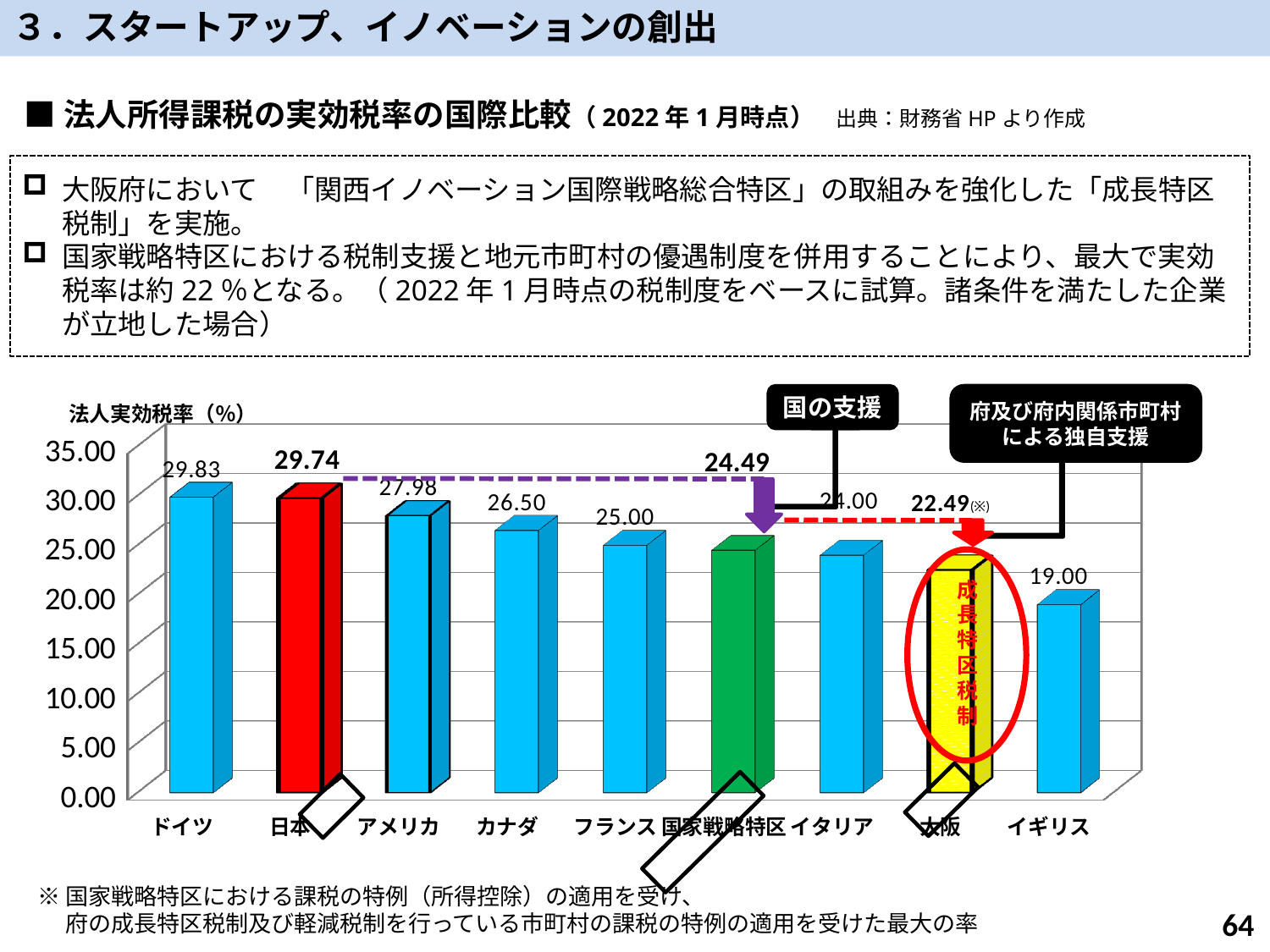
Which category has the lowest value? イギリス What kind of chart is shown on the slide? bar chart What is the value shown for 大阪? 22.49 What is the value shown for 国家戦略特区? 24.49 Is the value for フランス greater or less than 30.00? less What is the value shown for 日本? 29.74 What is the value shown for ドイツ? 29.83 What is the label of the vertical axis? 法人実効税率（%） Which is larger, the value for カナダ or the value for イタリア? カナダ Which category has the highest value? ドイツ How many categories are shown on the x axis? 9 What is the difference between the values for アメリカ and イギリス? 8.98